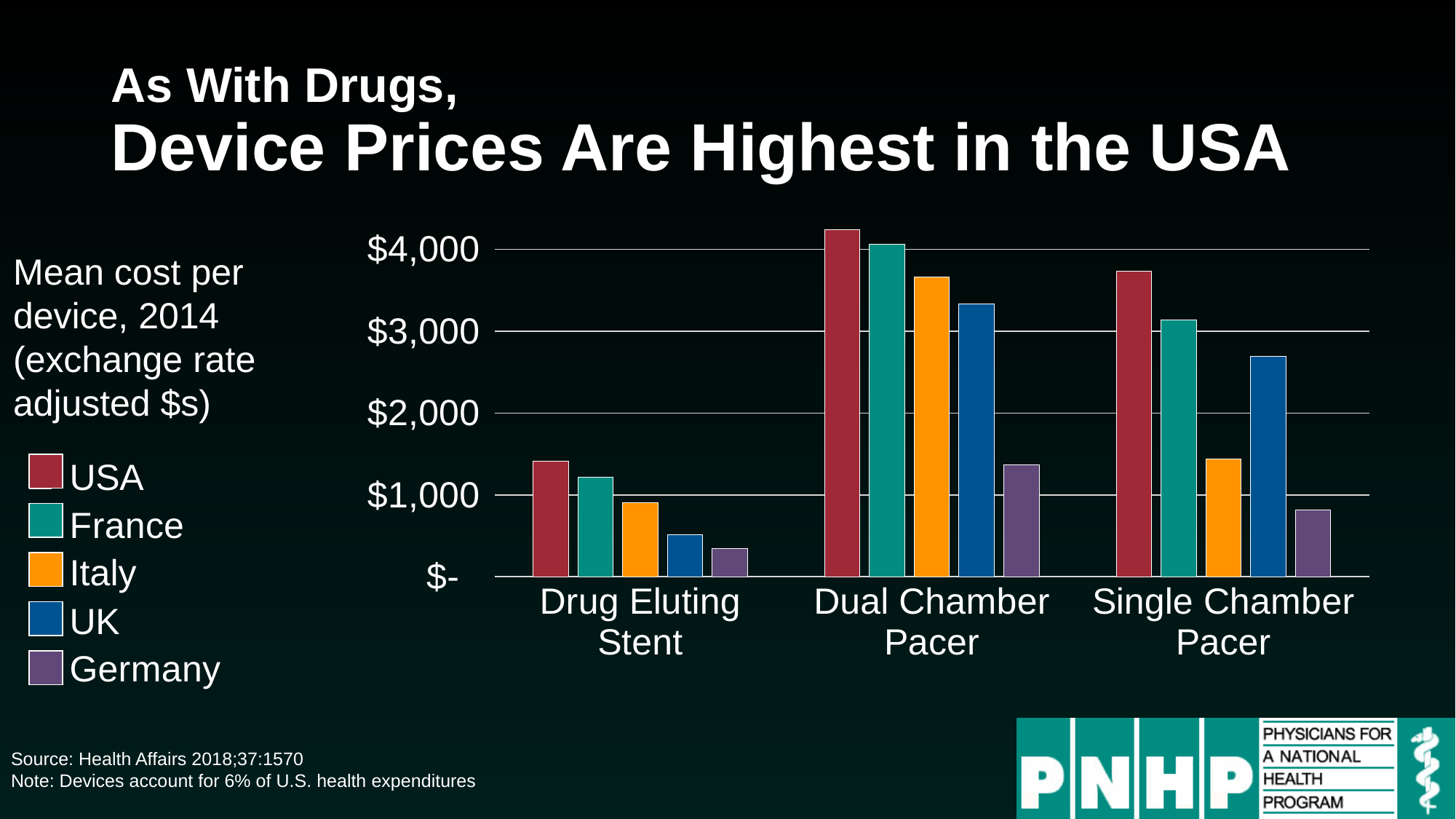
Which country has the highest mean cost for a Dual Chamber Pacer? USA For the Single Chamber Pacer, which is larger: the UK value or the Italy value? UK How many device categories are shown on the x axis? 3 Is the Germany value for Drug Eluting Stent greater or less than $1,000? less How many countries does the legend list? 5 Which country is represented by the orange bars in the legend? Italy Is the UK value for Single Chamber Pacer greater or less than $2,000? greater What kind of chart is shown on the slide? bar chart Which country has the lowest mean cost for a Single Chamber Pacer? Germany Which country has the lowest mean cost for a Drug Eluting Stent? Germany Is the USA value for Single Chamber Pacer greater or less than $3,000? greater